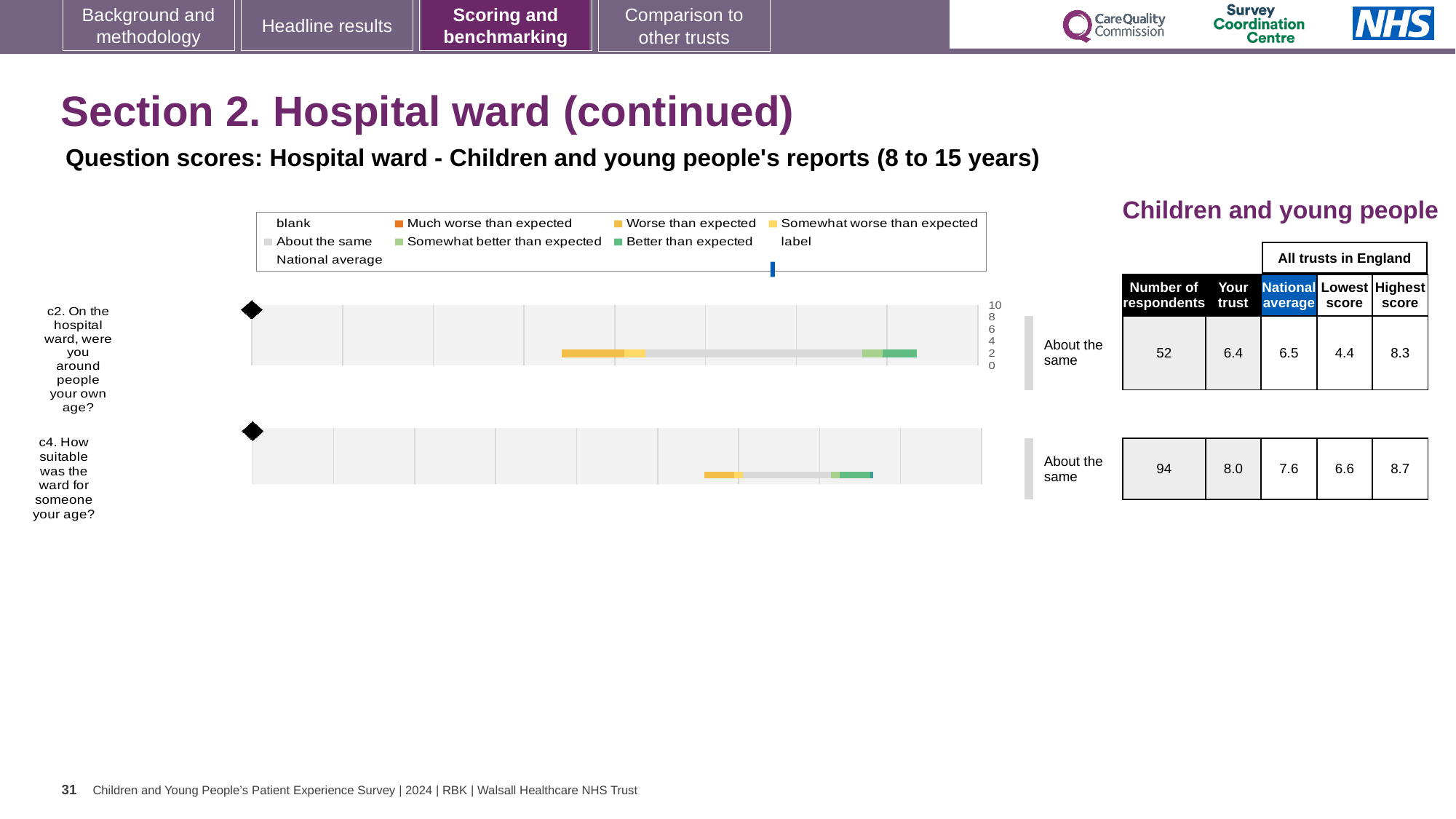
What kind of chart is used to show the question scores? Bar chart For question c4, how much higher is the 'Your trust' score than the national average? 0.4 How many respondents answered question c4? 94 For question c2, which is larger: the 'Your trust' score or the national average? National average What is the national average score for question c4 (How suitable was the ward for someone your age?)? 7.6 Which question has the higher 'Your trust' score, c2 or c4? c4 What is the 'Your trust' score for question c2 (On the hospital ward, were you around people your own age?)? 6.4 For question c2, what is the difference between the highest and lowest scores across all trusts in England? 3.9 What is the highest score across all trusts in England for question c2? 8.3 What is the lowest score across all trusts in England for question c4? 6.6 How many questions are plotted on this slide? 2 What benchmark rating is shown for question c4? About the same